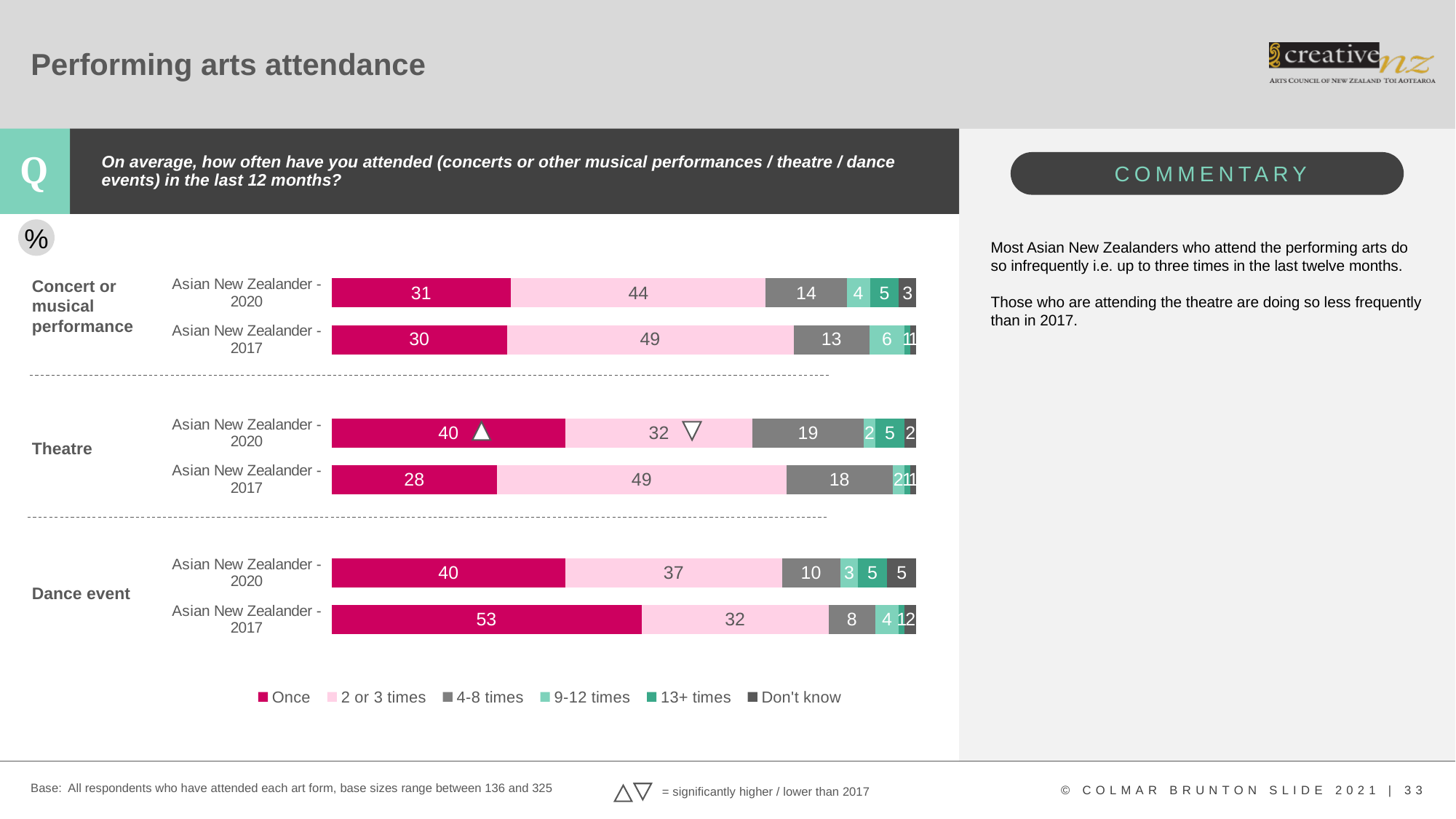
What is the 'Once' value for Dance event, Asian New Zealander - 2017? 53 Which is larger: the '2 or 3 times' value for Concert or musical performance 2020 or for Theatre 2020? Concert or musical performance 2020 What is the '4-8 times' value for Theatre, Asian New Zealander - 2020? 19 Which legend entry is shown in the darkest grey colour? Don't know How many series does the legend list? 6 What is the difference between the 'Once' values for Theatre in 2020 and 2017? 12 What is the 'Don't know' value for Dance event, Asian New Zealander - 2020? 5 Which bar has the highest 'Once' value? Dance event, Asian New Zealander - 2017 How many bars are shown in the chart? 6 What percentage of Asian New Zealanders in 2020 attended a concert or musical performance once? 31 What type of chart is shown on the slide? Stacked bar chart What is the '2 or 3 times' value for Theatre, Asian New Zealander - 2017? 49